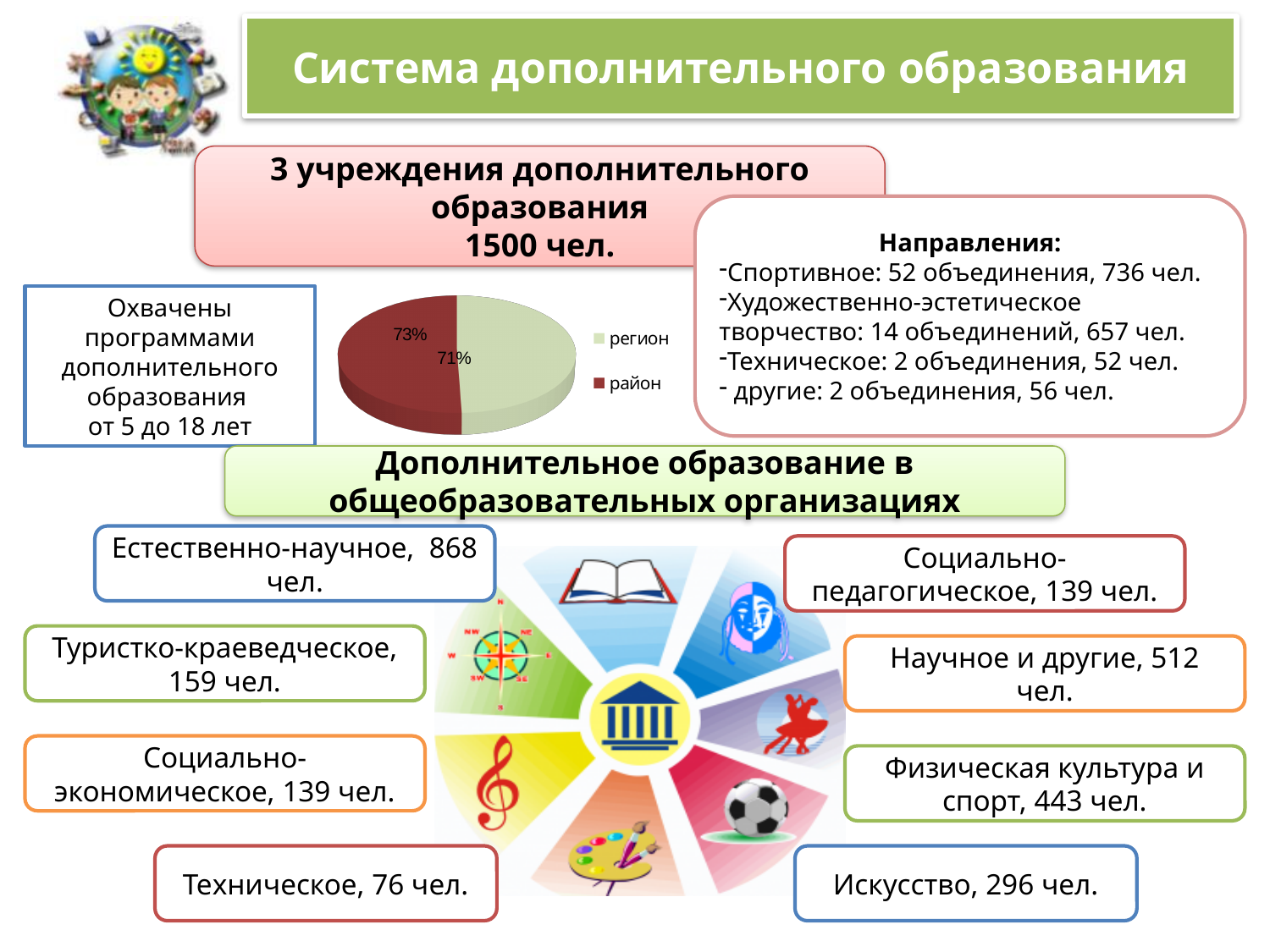
What entries does the legend of the pie chart list? регион, район How many slices does the pie chart have? 2 What is the larger of the two percentage labels shown on the pie chart? 73% What is the difference between the two percentage labels shown on the pie chart? 2% What kind of chart is shown on the slide? pie chart What colour is the район slice in the pie chart? dark red What two percentage values are labelled on the pie chart? 73% and 71% What is the smaller of the two percentage labels shown on the pie chart? 71%